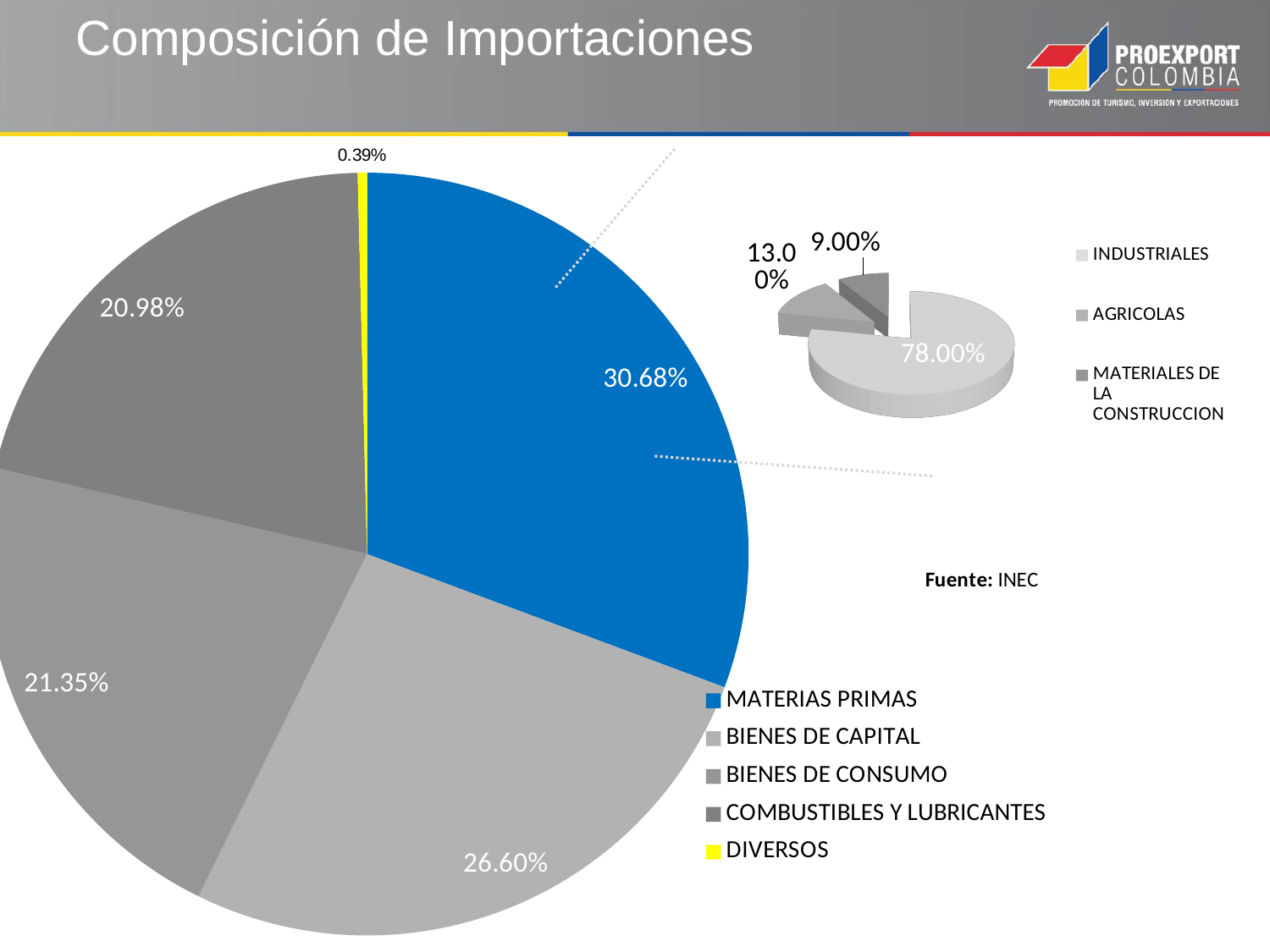
In the small pie chart on the right, what share does INDUSTRIALES have? 78.00% In the small pie chart on the right, what share does AGRICOLAS have? 13.00% In the small pie chart on the right, which category has the smallest share? MATERIALES DE LA CONSTRUCCION In the large pie chart on the left, what share does MATERIAS PRIMAS have? 30.68% In the large pie chart on the left, which is larger: BIENES DE CONSUMO or COMBUSTIBLES Y LUBRICANTES? BIENES DE CONSUMO In the large pie chart on the left, which category has the smallest share? DIVERSOS In the large pie chart on the left, what share does BIENES DE CAPITAL have? 26.60% How many categories does the legend of the large pie chart on the left list? 5 In the large pie chart on the left, what share does DIVERSOS have? 0.39% In the large pie chart on the left, what is the difference between the shares of MATERIAS PRIMAS and BIENES DE CAPITAL? 4.08% In the large pie chart on the left, which category has the largest share? MATERIAS PRIMAS What type of chart is the large chart on the left? Pie chart